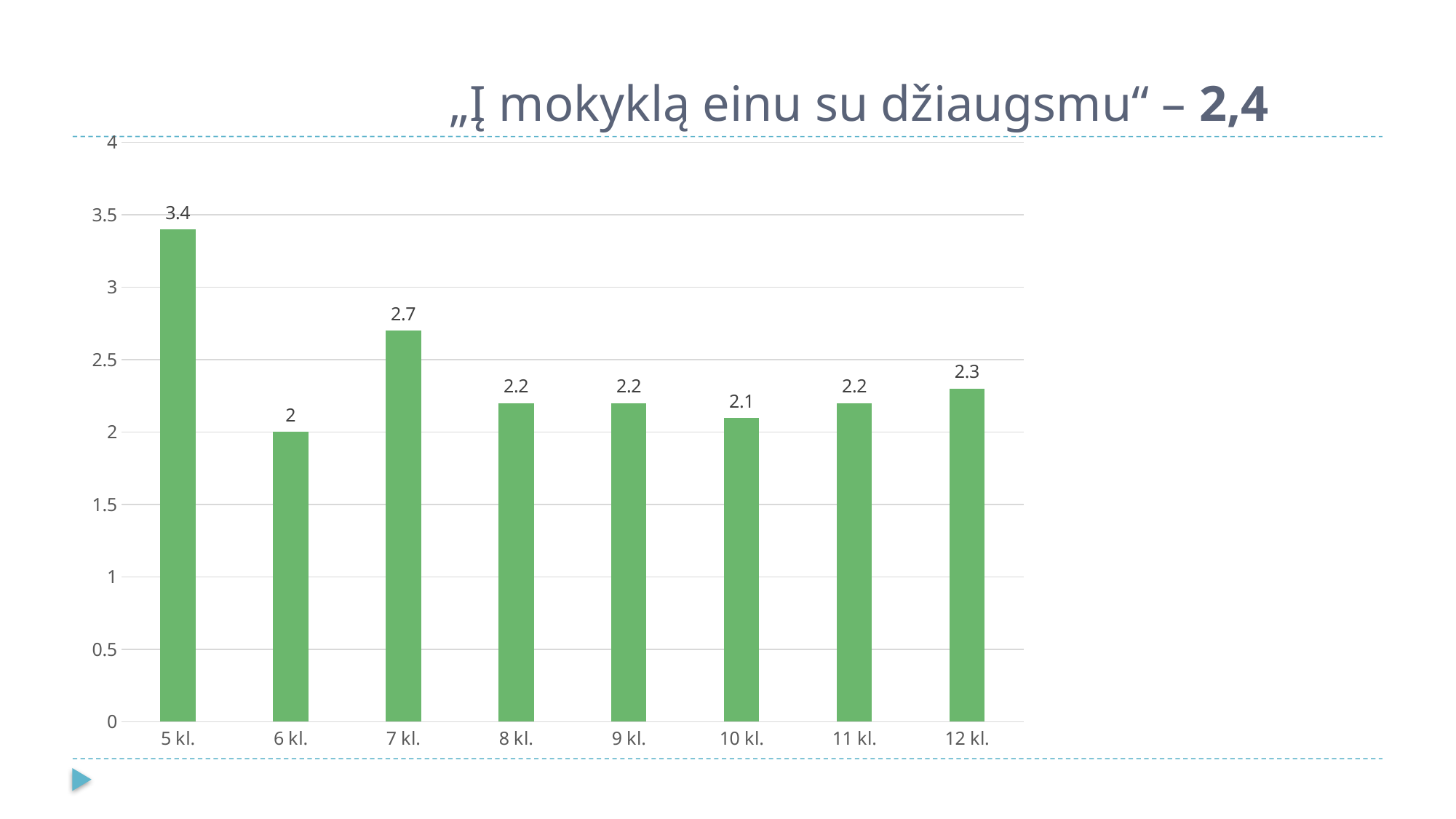
What is the value for 12 kl.? 2.3 Is the value for 5 kl. greater or less than 3? greater What is the value for 10 kl.? 2.1 Which is larger, the value for 7 kl. or the value for 12 kl.? 7 kl. Which category has the highest value? 5 kl. What is the difference between the values for 5 kl. and 6 kl.? 1.4 What is the value for 5 kl.? 3.4 What is the value for 7 kl.? 2.7 What kind of chart is shown on the slide? bar chart How many categories are shown on the x axis? 8 Which category has the lowest value? 6 kl. What is the title of the slide? „Į mokyklą einu su džiaugsmu“ – 2,4